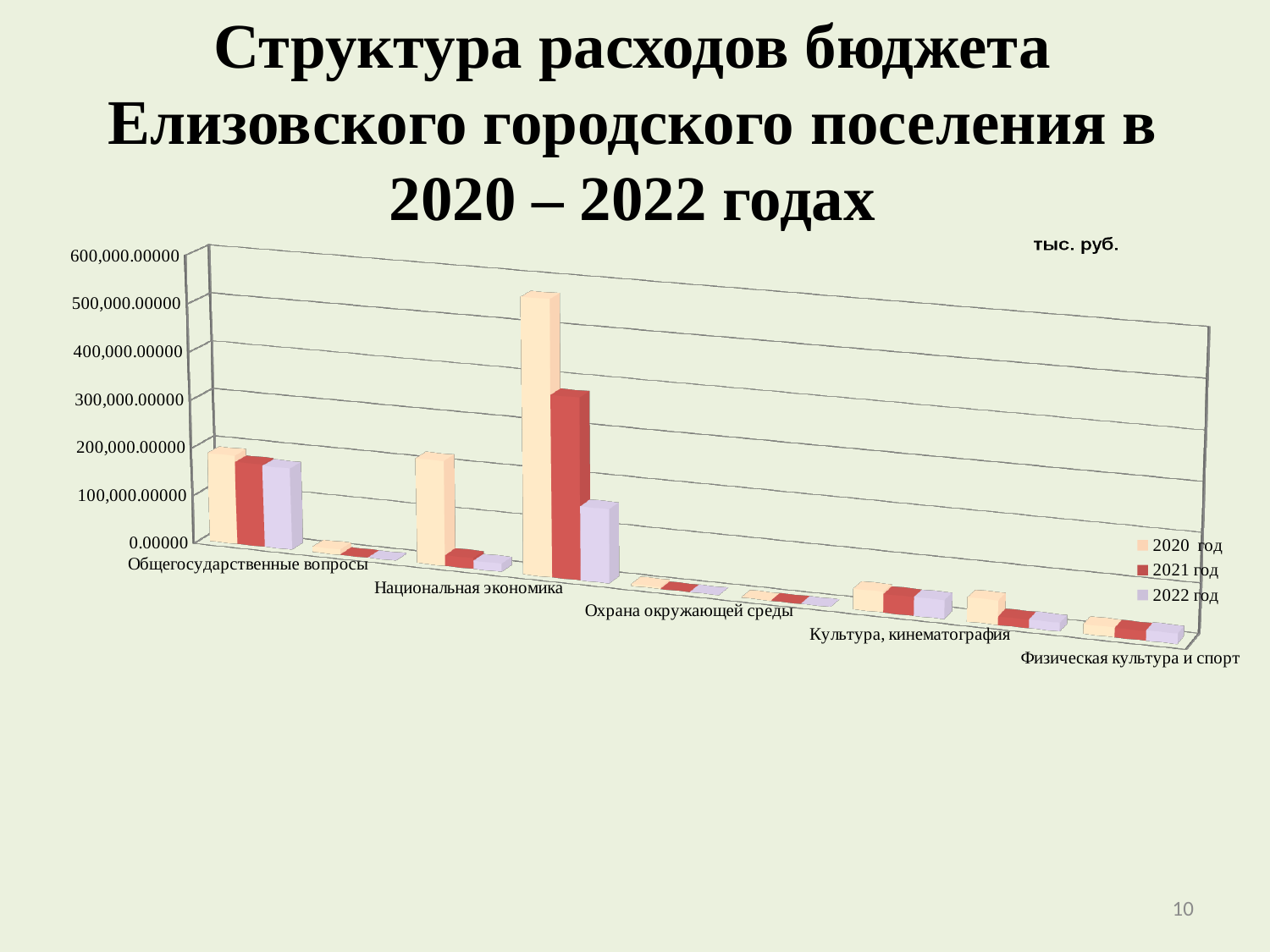
Is the 2020 год value for Национальная экономика greater or less than 100,000? greater What kind of chart is shown on the slide? bar chart Is the 2020 год value for Общегосударственные вопросы greater or less than 100,000? greater Is the 2020 год value for Общегосударственные вопросы greater or less than 300,000? less How many series does the legend list? 3 For Национальная экономика, which is larger: the 2020 год value or the 2021 год value? 2020 год Which is larger: the 2020 год value for Общегосударственные вопросы or the 2020 год value for Охрана окружающей среды? Общегосударственные вопросы What unit is indicated above the chart? тыс. руб. What are the three series listed in the legend? 2020 год, 2021 год, 2022 год For Национальная экономика, do the values rise or fall from 2020 год to 2022 год? fall